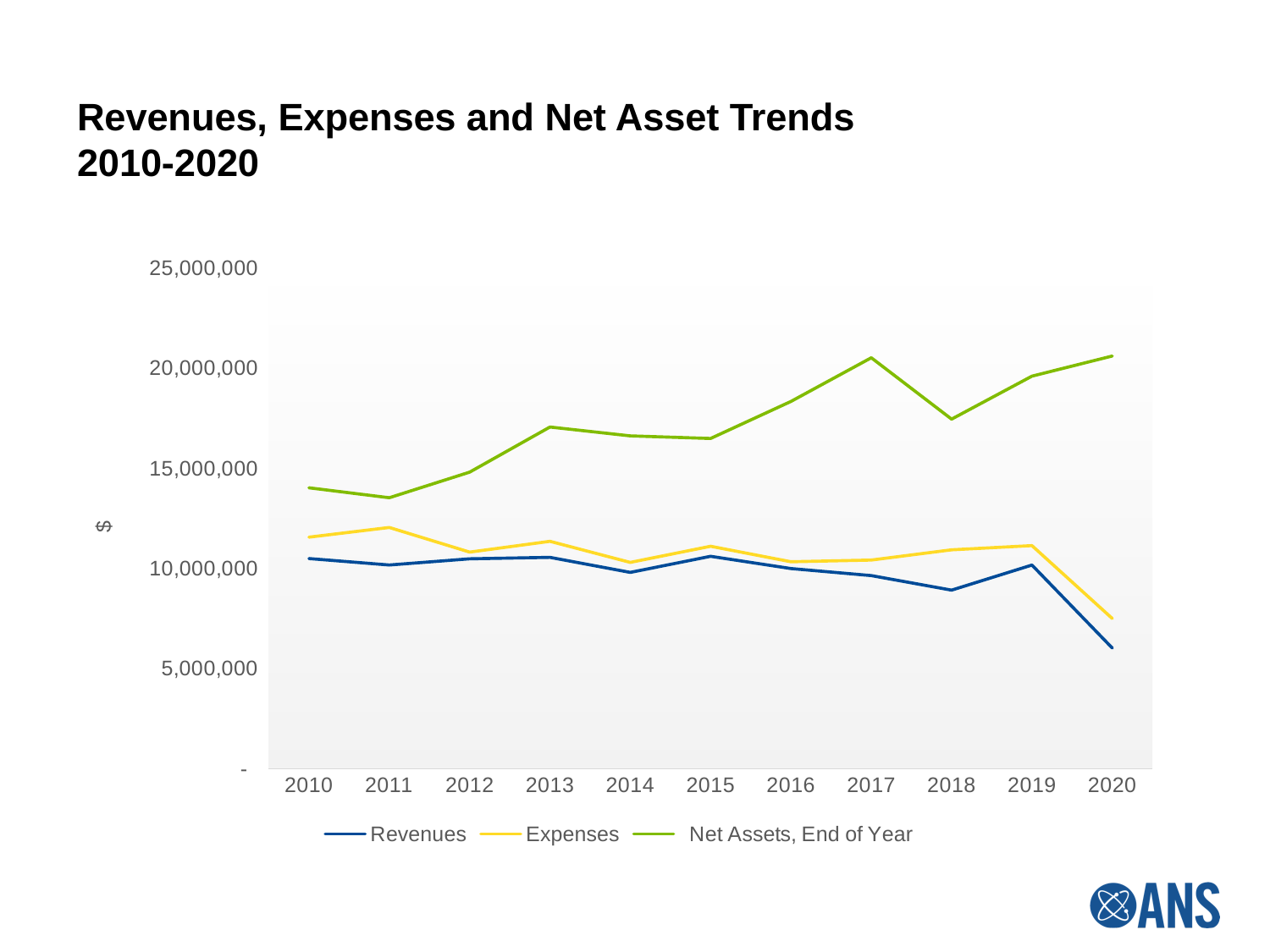
In which year is the Revenues line at its lowest? 2020 What is the title of the chart on the slide? Revenues, Expenses and Net Asset Trends 2010-2020 What kind of chart is shown on the slide? Line chart In which year is the Expenses line at its highest? 2011 Overall, does the Net Assets, End of Year line rise or fall from 2010 to 2020? Rise How many years are plotted along the x axis? 11 Is the value for Expenses in 2020 greater or less than 10,000,000? less Is the value for Net Assets, End of Year in 2018 greater or less than 20,000,000? less In 2020, which is larger: Revenues or Expenses? Expenses Is the value for Net Assets, End of Year in 2017 greater or less than 20,000,000? greater How many series does the legend list? 3